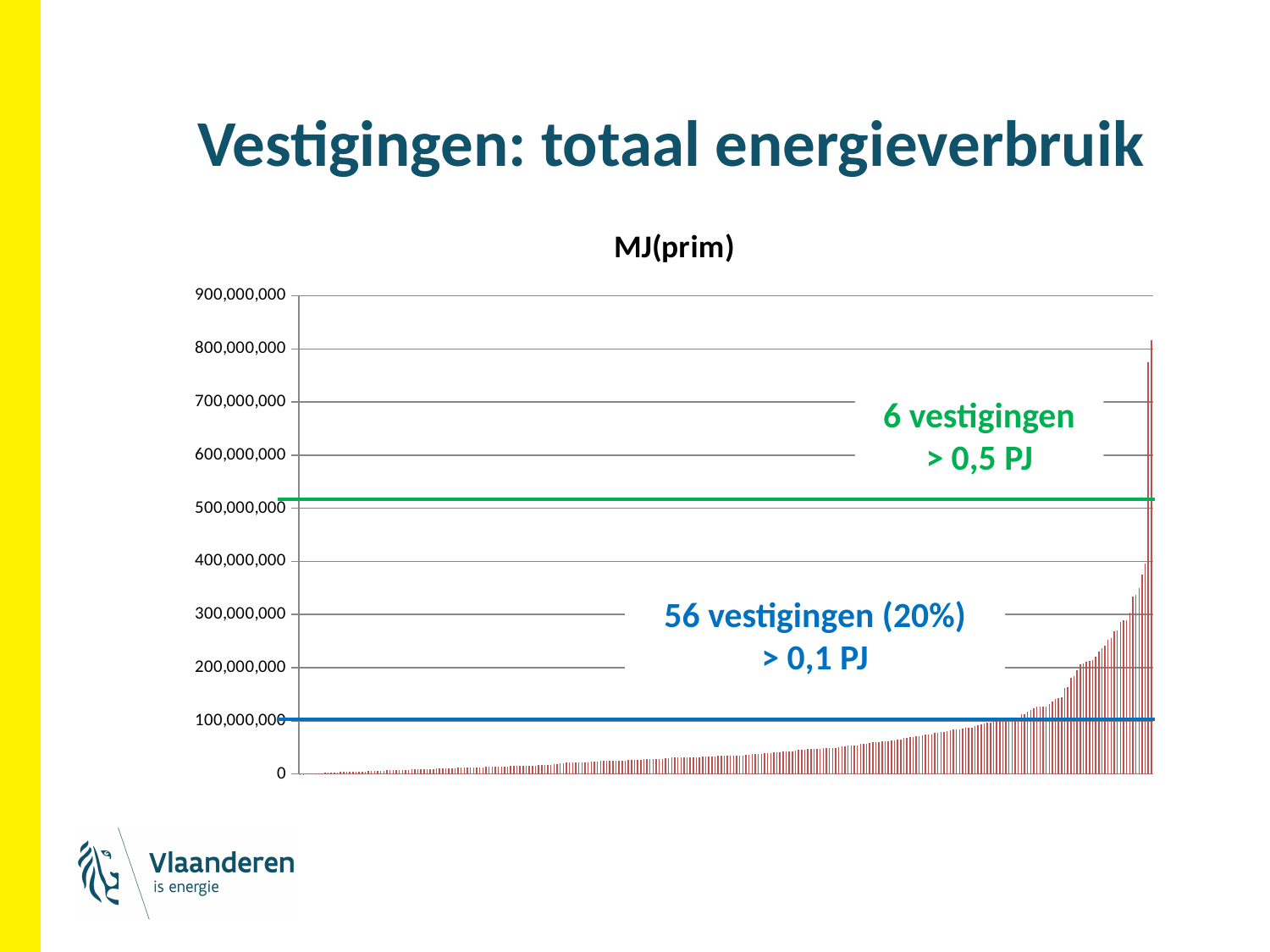
Is the value of the leftmost bar greater or less than 100,000,000? less What percentage of vestigingen is stated to have a consumption above 0,1 PJ? 20% According to the annotation, how many vestigingen have a consumption above 0,1 PJ? 56 What kind of chart is shown on the slide? bar chart Is the value of the tallest bar greater or less than 900,000,000? less Is the value of the tallest bar greater or less than 700,000,000? greater Do the bar values rise or fall from left to right along the x axis? rise What is the title shown above the chart? MJ(prim) According to the annotation, how many vestigingen have a consumption above 0,5 PJ? 6 What is the highest value shown on the y axis? 900,000,000